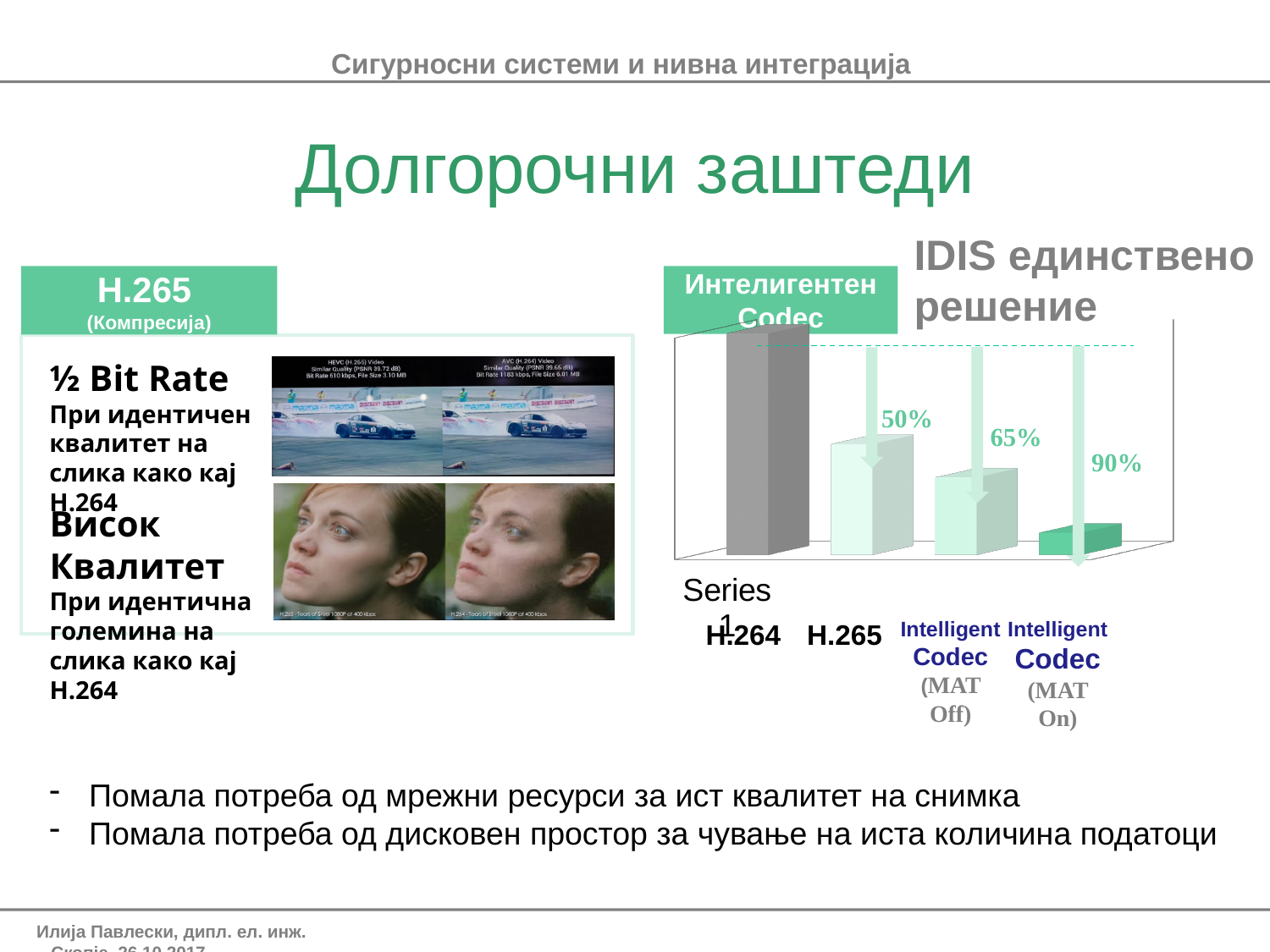
What percentage is annotated next to the Intelligent Codec (MAT Off) bar in the chart? 65% What percentage is annotated next to the Intelligent Codec (MAT On) bar in the chart? 90% What percentage is annotated next to the H.265 bar in the chart? 50% Which bar is taller, Intelligent Codec (MAT Off) or Intelligent Codec (MAT On)? Intelligent Codec (MAT Off) Which category has the shortest bar in the chart? Intelligent Codec (MAT On) Which bar is taller, H.264 or H.265? H.264 Do the bar heights rise or fall from left to right across the chart? fall How many bars does the chart on the right side of the slide have? 4 Which category has the tallest bar in the chart? H.264 What kind of chart is shown on the right side of the slide? bar chart